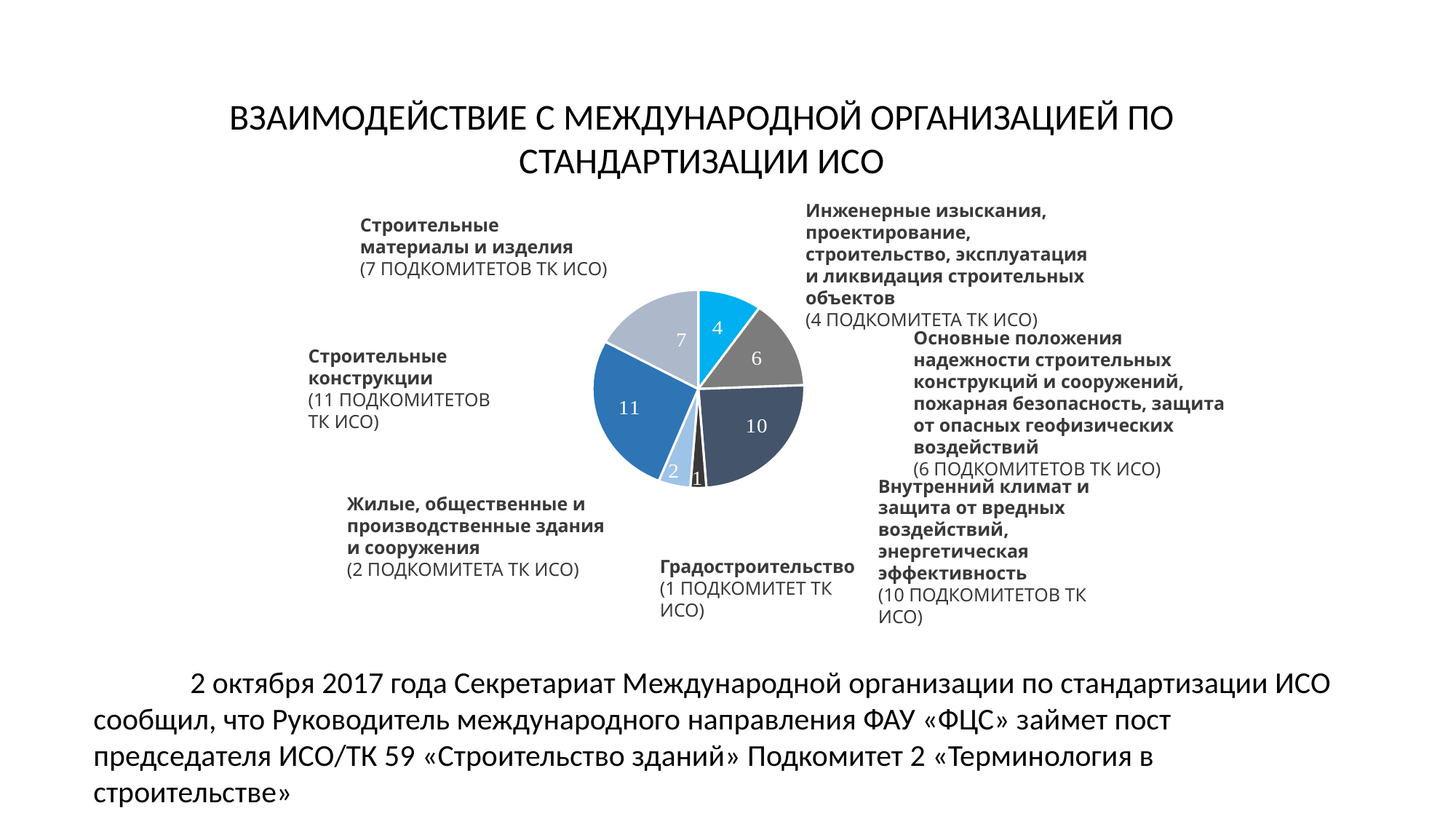
How many subcommittees are shown for Строительные конструкции? 11 How many slices does the pie chart have? 7 Which category has the smallest slice of the pie chart? Градостроительство What kind of chart is shown on the slide? Pie chart What value is shown for Градостроительство? 1 What is the total of all values in the pie chart? 41 What value is shown for Внутренний климат и защита от вредных воздействий, энергетическая эффективность? 10 What colour is the slice for Градостроительство? Black What is the difference between the values for Строительные конструкции and Строительные материалы и изделия? 4 Which category has the largest slice of the pie chart? Строительные конструкции Which is larger: the value for Инженерные изыскания, проектирование, строительство, эксплуатация и ликвидация строительных объектов or the value for Основные положения надежности строительных конструкций и сооружений, пожарная безопасность, защита от опасных геофизических воздействий? Основные положения надежности строительных конструкций и сооружений, пожарная безопасность, защита от опасных геофизических воздействий What value is shown for Строительные материалы и изделия? 7